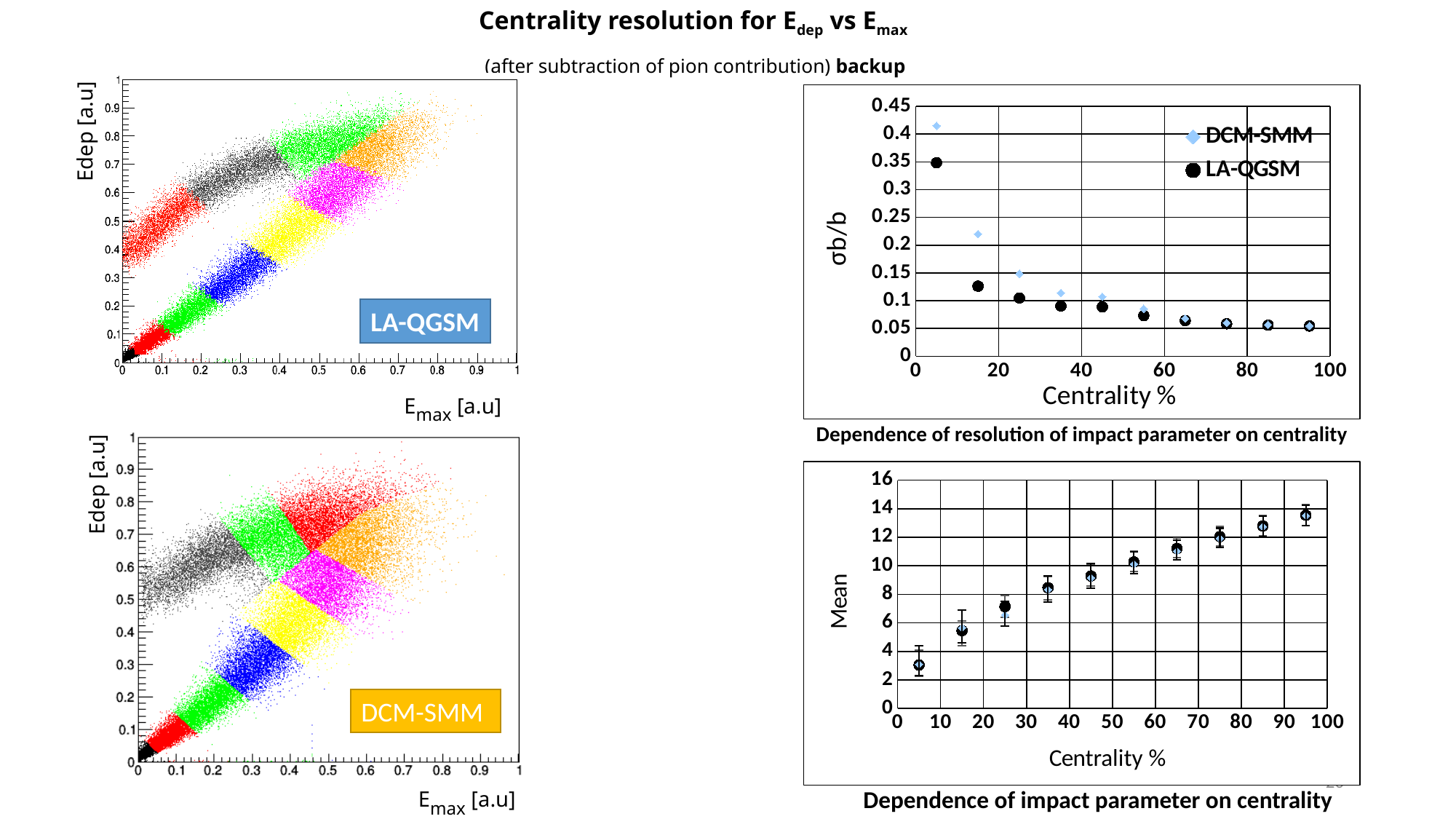
In the chart titled 'Dependence of impact parameter on centrality', is the Mean value at 5% centrality greater or less than 4? less In the chart titled 'Dependence of resolution of impact parameter on centrality', how many series does the legend list? 2 What kind of chart is the top-left chart labelled LA-QGSM? scatter plot In the chart titled 'Dependence of impact parameter on centrality', is the Mean value at 95% centrality greater or less than 12? greater In the chart titled 'Dependence of resolution of impact parameter on centrality', at which centrality is the DCM-SMM σb/b value highest? 5% In the chart titled 'Dependence of resolution of impact parameter on centrality', which series has the larger σb/b value at 15% centrality, DCM-SMM or LA-QGSM? DCM-SMM In the chart titled 'Dependence of resolution of impact parameter on centrality', is the DCM-SMM value at 5% centrality greater or less than 0.4? greater In the chart titled 'Dependence of impact parameter on centrality', how many data points are plotted along the centrality axis? 10 In the chart titled 'Dependence of impact parameter on centrality', do the Mean values rise or fall as centrality increases? rise In the chart titled 'Dependence of resolution of impact parameter on centrality', do the σb/b values rise or fall as centrality increases? fall In the chart titled 'Dependence of resolution of impact parameter on centrality', what are the two series named in the legend? DCM-SMM and LA-QGSM